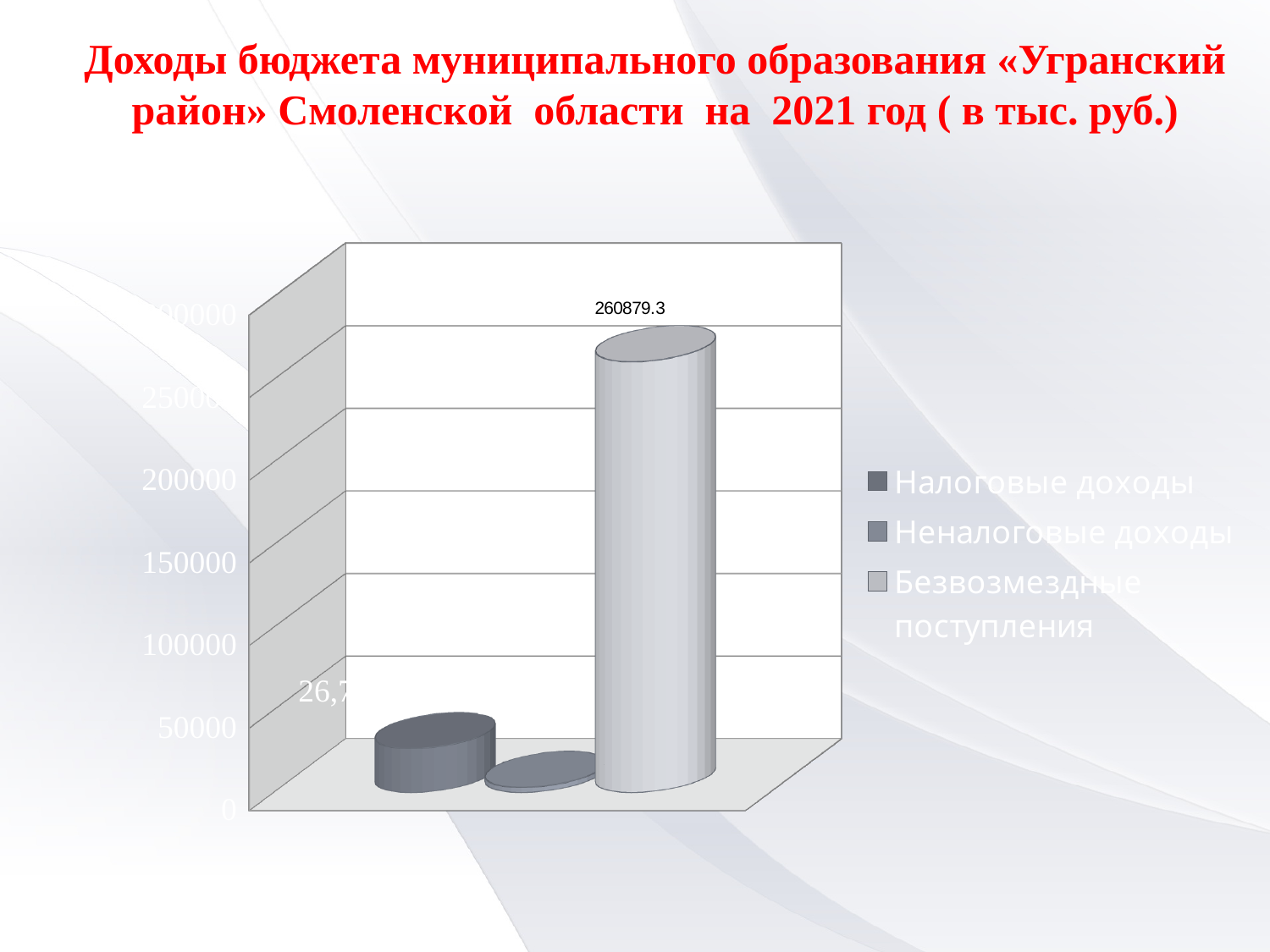
Is the value for Неналоговые доходы greater or less than 50000? less What is the value for Безвозмездные поступления? 260879.3 Which is larger, Налоговые доходы or Неналоговые доходы? Налоговые доходы What unit of measurement is stated in the slide title? тыс. руб. Is the value for Безвозмездные поступления greater or less than 250000? greater How many series does the legend list? 3 How many bars are plotted on the chart? 3 Which year does the chart title refer to? 2021 Which series has the highest value? Безвозмездные поступления Which series has the lowest value? Неналоговые доходы Is the value for Налоговые доходы greater or less than 50000? less What kind of chart is shown on the slide? bar chart